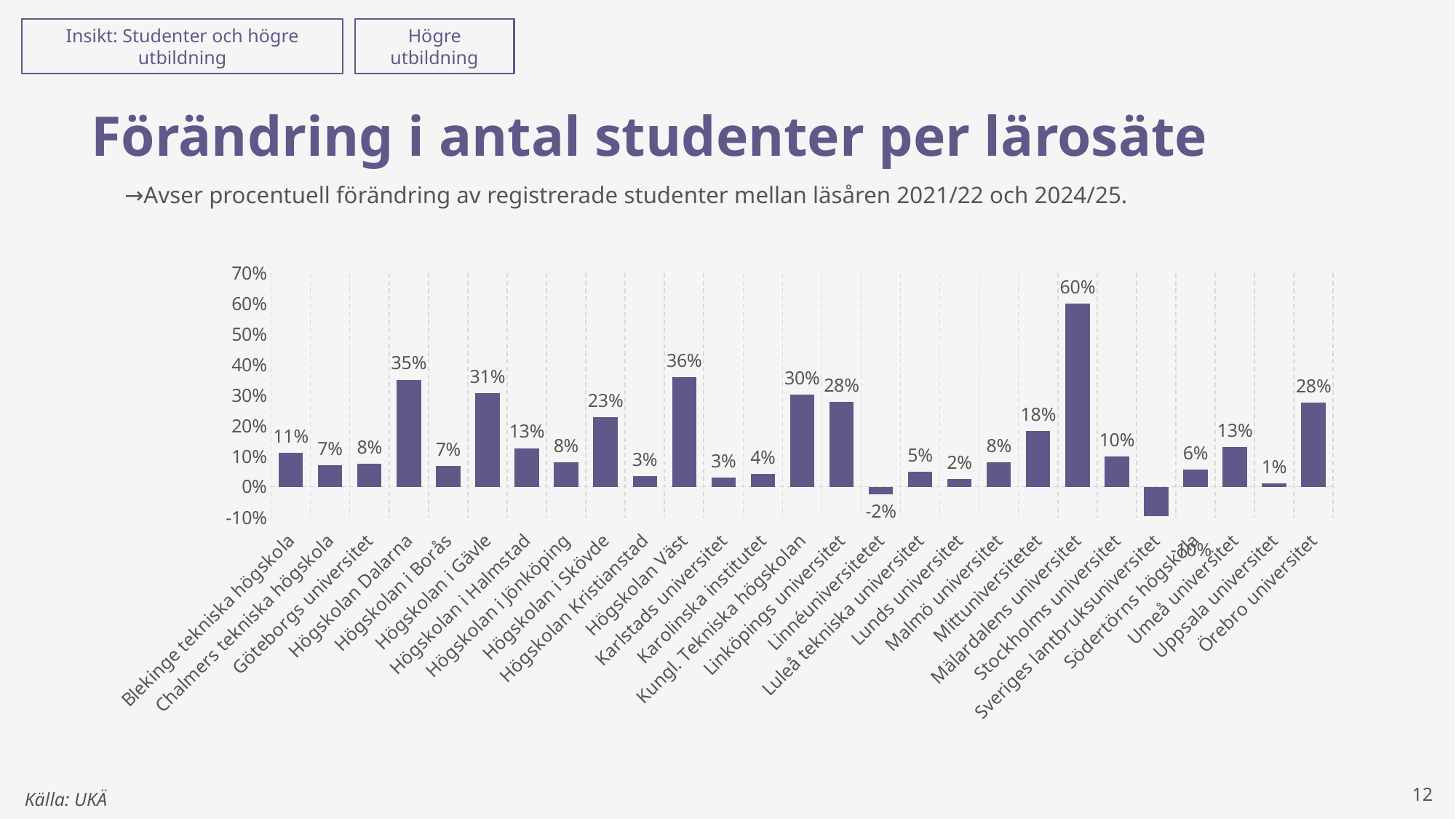
Which institution has the lowest value in the chart? Sveriges lantbruksuniversitet What is the value for Linnéuniversitetet? -2% Which is larger, the value for Kungl. Tekniska högskolan or the value for Linköpings universitet? Kungl. Tekniska högskolan Is the value for Mittuniversitetet greater or less than 20%? less What is the source cited for the chart? UKÄ What is the value for Uppsala universitet? 1% What is the difference between the values for Högskolan Dalarna and Högskolan i Gävle? 4 percentage points What is the value for Högskolan Väst? 36% How many institutions are shown in the chart? 27 What is the value for Mälardalens universitet? 60% What kind of chart is shown on the slide? Bar chart Which institution has the highest value in the chart? Mälardalens universitet